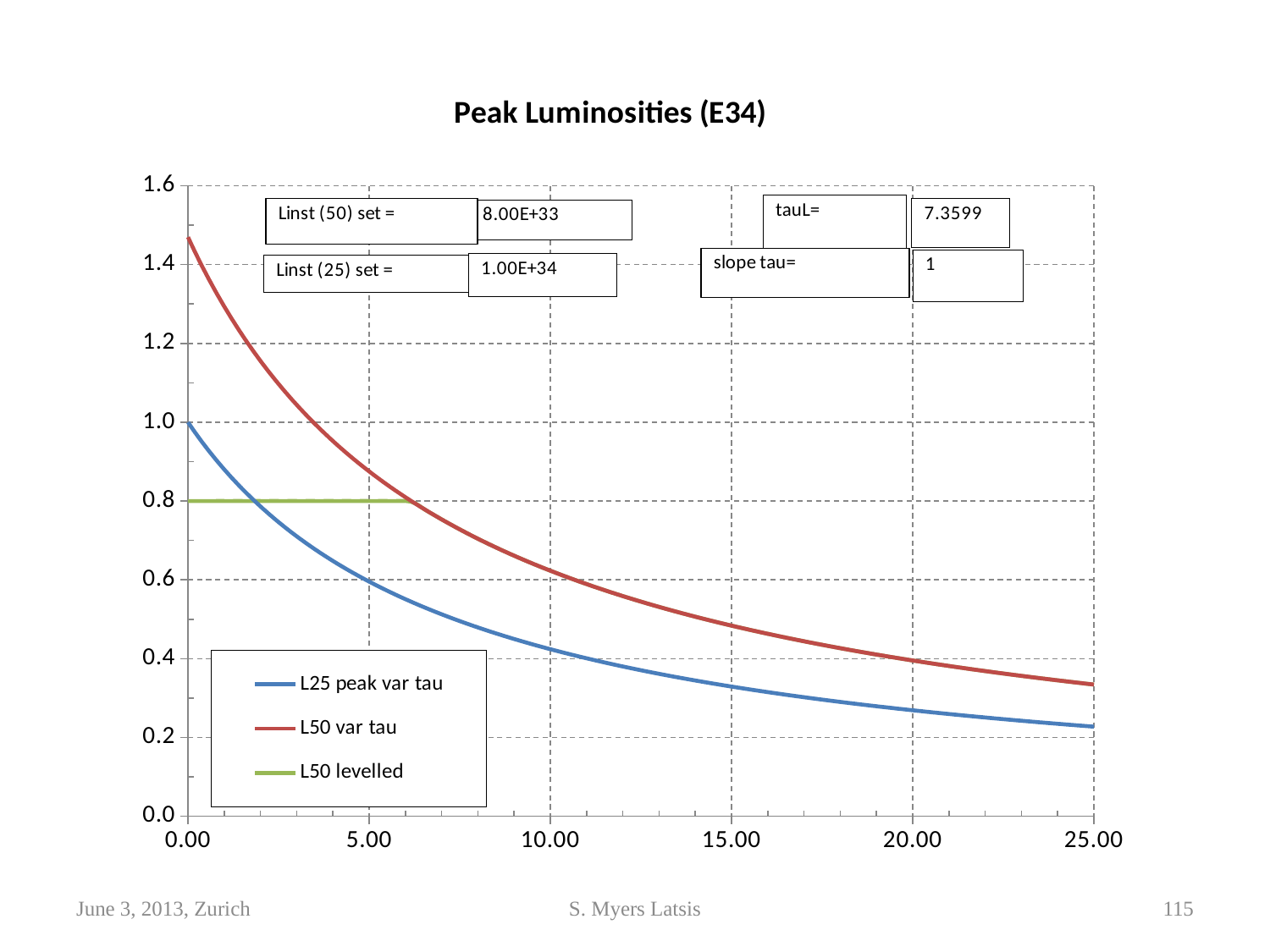
What value is given for tauL in the text box on the chart? 7.3599 Does the L50 var tau series rise or fall as the x axis increases? fall Is the value of L50 var tau at x = 25.00 greater or less than 0.4? less Does the L25 peak var tau series rise or fall as the x axis increases? fall Is the value of L50 var tau at x = 0.00 greater or less than 1.4? greater What constant value does the L50 levelled series hold? 0.8 At x = 10.00, which series is higher, L50 var tau or L25 peak var tau? L50 var tau What is the value of L25 peak var tau at x = 0.00? 1.0 What type of chart is shown on the slide? line chart How many series does the legend list? 3 Is the value of L25 peak var tau at x = 25.00 greater or less than 0.4? less What is the title of the chart? Peak Luminosities (E34)